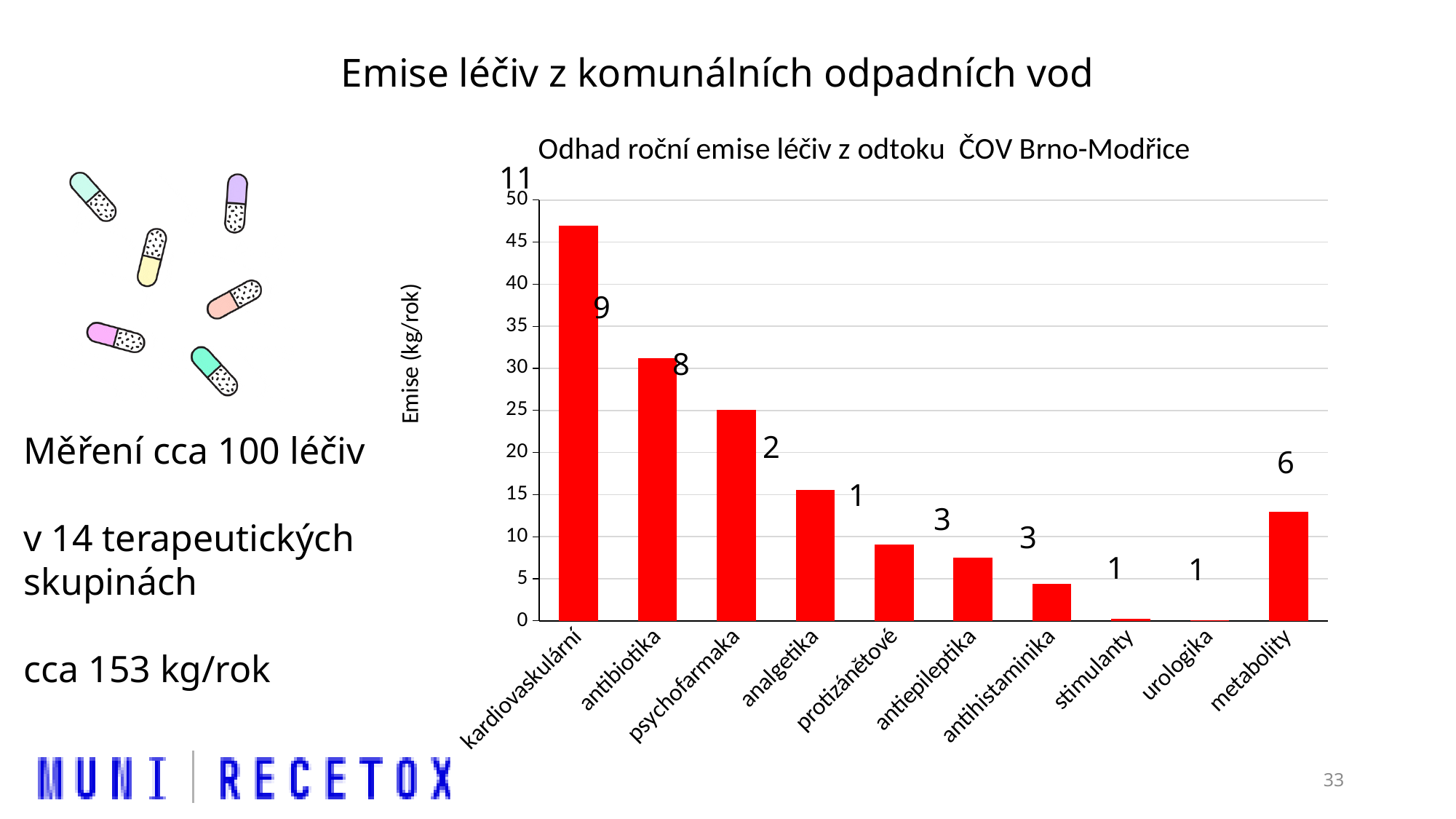
What kind of chart is shown on the slide? bar chart Which therapeutic group has the highest emission in the chart? kardiovaskulární Is the value for antihistaminika greater or less than 5? less How many therapeutic groups (categories) are plotted on the x axis of the chart? 10 Is the value for antibiotika greater or less than 35? less Which has a larger emission, metabolity or antiepileptika? metabolity Is the value for psychofarmaka greater or less than 20? greater Which has a larger emission, antibiotika or psychofarmaka? antibiotika What is the label of the y axis of the chart? Emise (kg/rok)